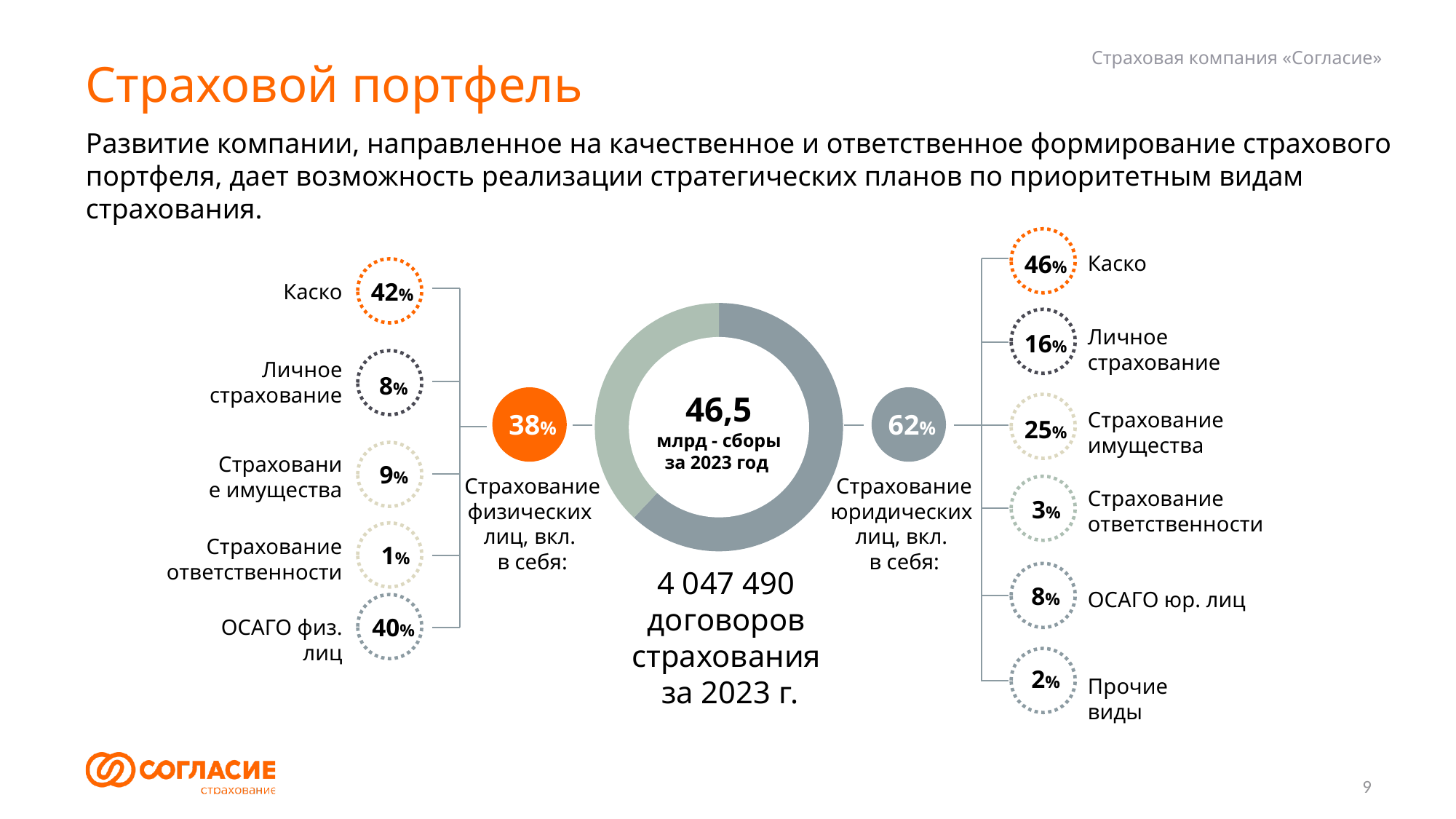
In the breakdown of «Страхование юридических лиц» on the right, what is the share of «Страхование имущества»? 25% What kind of chart is shown in the centre of the slide? Donut (pie) chart In the breakdown of «Страхование физических лиц» on the left, which category has the lowest share? Страхование ответственности In the breakdown of «Страхование физических лиц» on the left, what is the share of «Каско»? 42% What share of the donut chart is attributed to «Страхование юридических лиц»? 62% Which segment of the donut chart is larger: «Страхование физических лиц» or «Страхование юридических лиц»? Страхование юридических лиц What share of the donut chart is attributed to «Страхование физических лиц»? 38% What is the difference in percentage points between the «Страхование юридических лиц» and «Страхование физических лиц» segments of the donut chart? 24 percentage points How many segments does the donut chart have? 2 What value is printed in the centre of the donut chart? 46,5 млрд - сборы за 2023 год How many insurance contracts for 2023 are stated below the donut chart? 4 047 490 In the breakdown of «Страхование юридических лиц» on the right, which category has the highest share? Каско